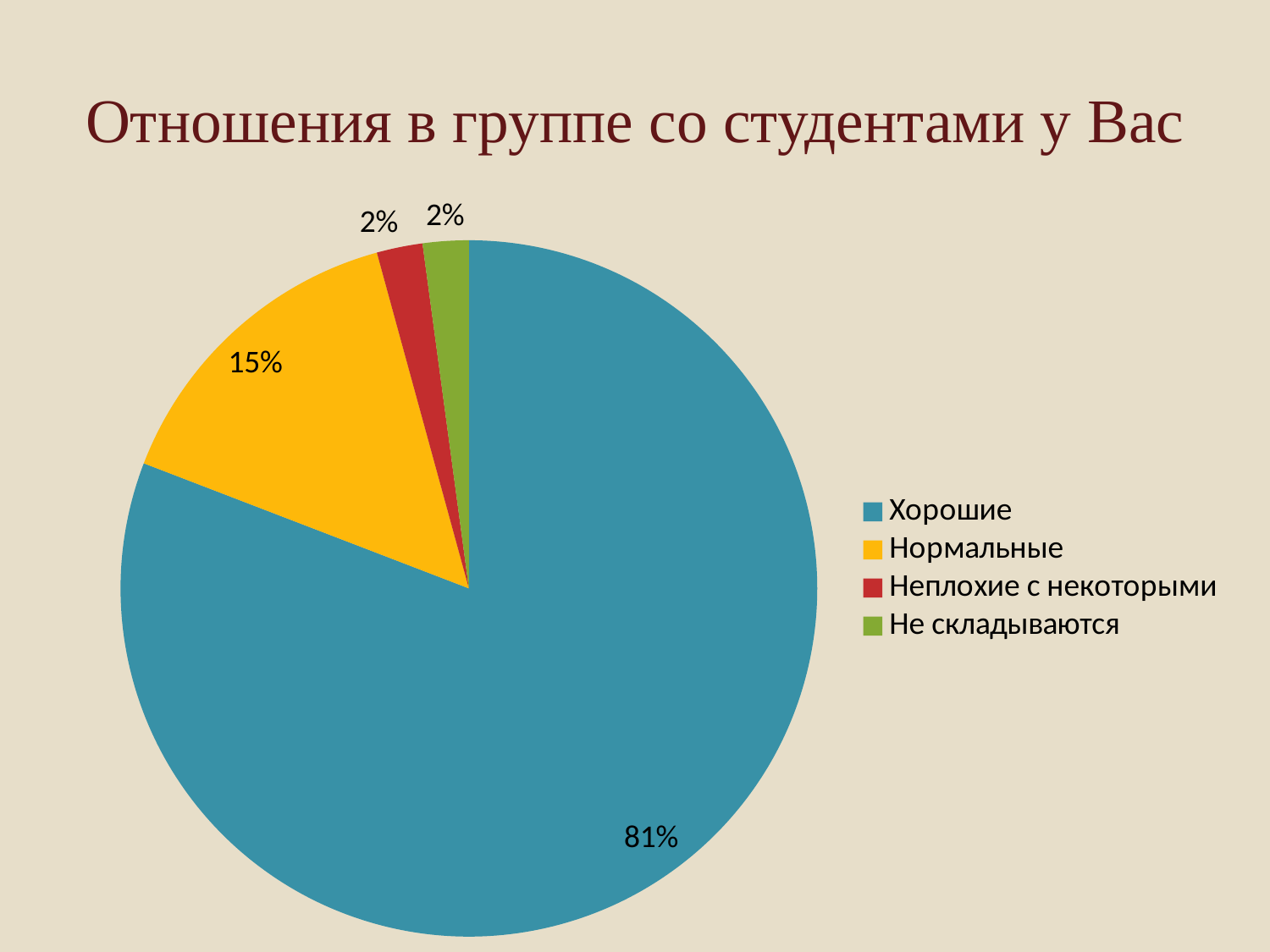
Which is larger, the share of "Нормальные" or the share of "Не складываются"? Нормальные What type of chart is shown on the slide? pie chart What share of the pie does "Хорошие" take? 81% What share of the pie does "Нормальные" take? 15% What share of the pie does "Неплохие с некоторыми" take? 2% What is the difference between the shares of "Хорошие" and "Нормальные"? 66% What is the title of the chart? Отношения в группе со студентами у Вас How many categories does the legend list? 4 Which category has the largest slice of the pie? Хорошие What is the combined share of "Неплохие с некоторыми" and "Не складываются"? 4% What colour is the slice for "Нормальные"? yellow